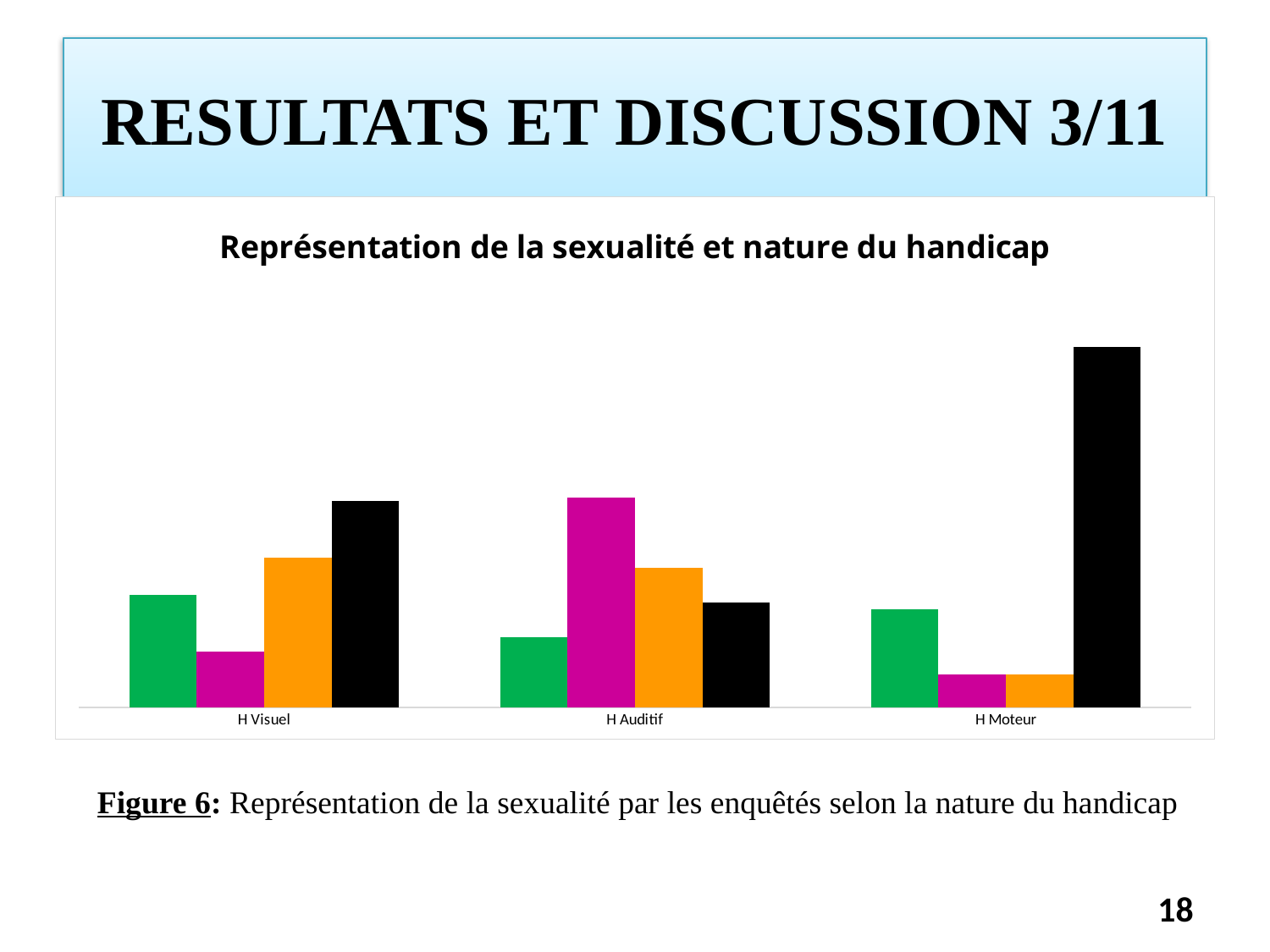
Which category contains the tallest bar in the chart? H Moteur Is the black bar taller for H Moteur or for H Visuel? H Moteur Within the H Visuel category, which coloured bar is the shortest? magenta How many categories are shown on the x axis of the chart? 3 Does the chart display a legend identifying the coloured series? No What kind of chart is shown on the slide? bar chart What is the title of the chart? Représentation de la sexualité et nature du handicap Within the H Auditif category, which coloured bar is the tallest? magenta Within the H Moteur category, which coloured bar is the tallest? black Within the H Auditif category, which coloured bar is the shortest? green How many bars are plotted for each category in the chart? 4